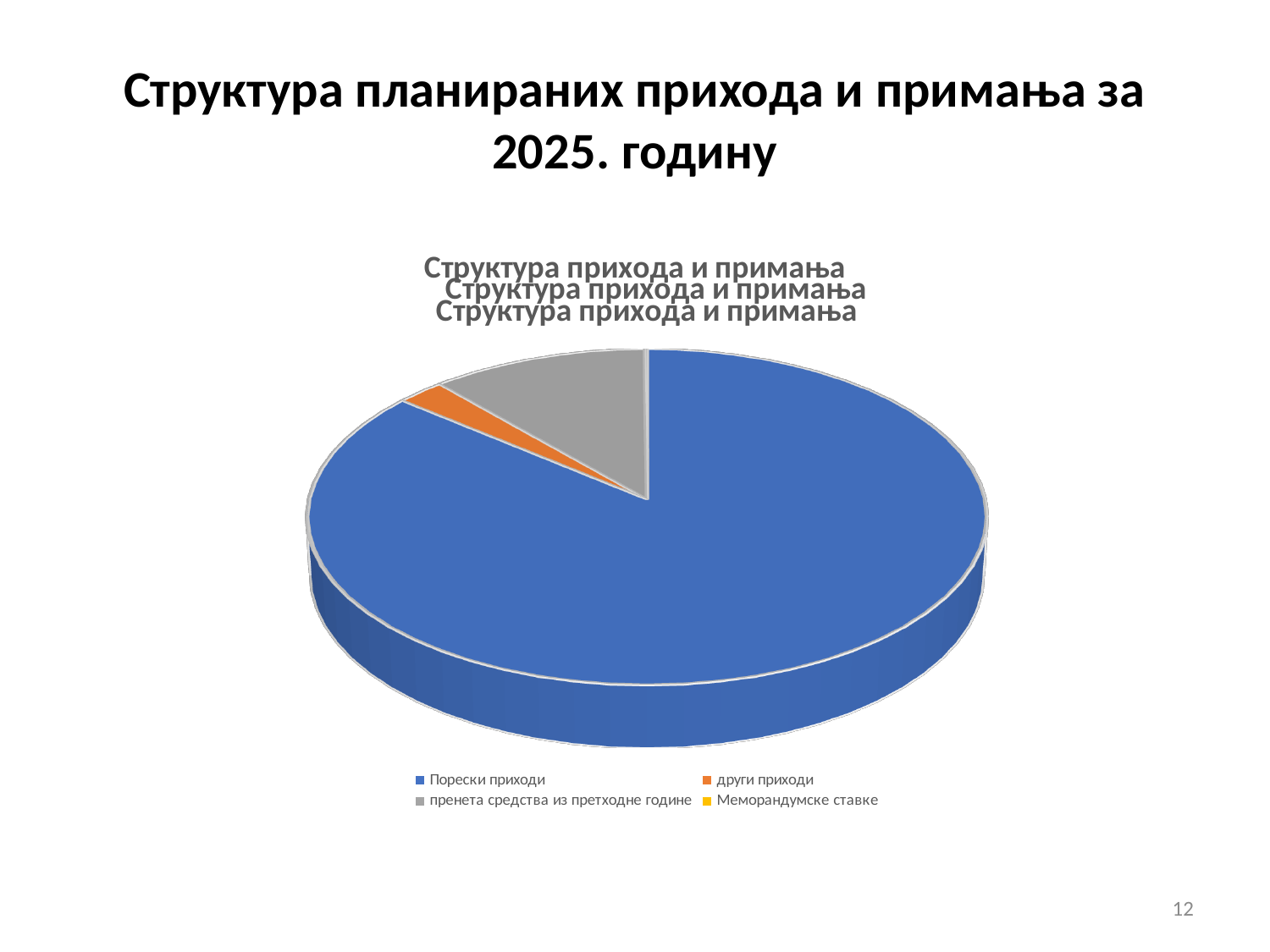
What colour is the slice for Порески приходи? blue Does the Порески приходи slice take up more or less than half of the pie? more Which slice is larger, Порески приходи or пренета средства из претходне године? Порески приходи Which category has the largest slice of the pie? Порески приходи Which slice is larger, други приходи or пренета средства из претходне године? пренета средства из претходне године How many categories does the chart legend list? 4 What kind of chart is shown on the slide? pie chart What is the title of the chart? Структура прихода и примања